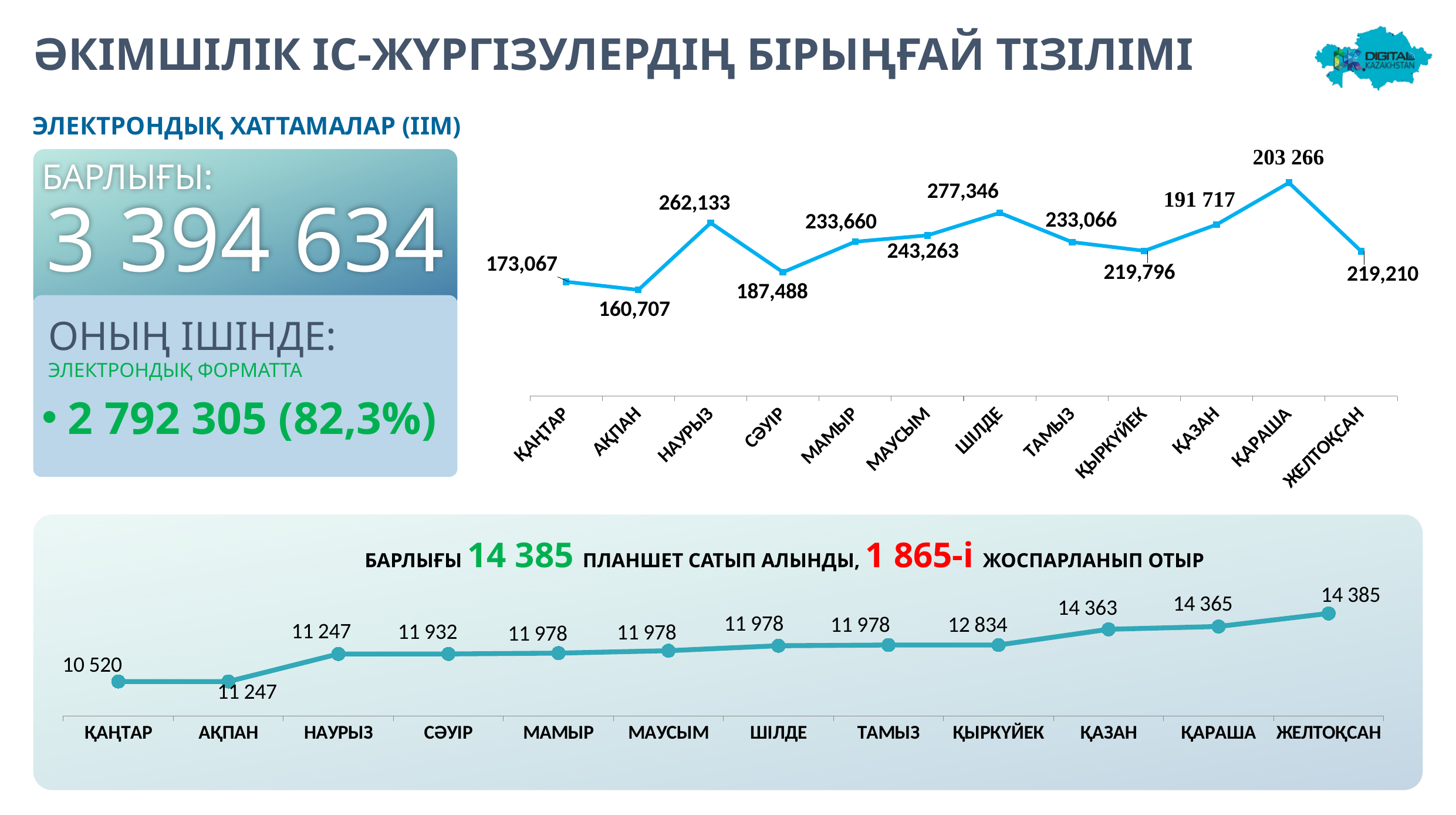
How many months are plotted in the top chart (electronic protocols)? 12 In the bottom chart (tablets), what is the difference between the values for ЖЕЛТОҚСАН and ҚАҢТАР? 3 865 In the top chart (electronic protocols), which is larger: the value for МАМЫР or the value for ҚЫРКҮЙЕК? МАМЫР In the top chart (electronic protocols), what is the value for ҚАҢТАР? 173,067 In the bottom chart (tablets), which month has the lowest value? ҚАҢТАР What kind of chart is the top chart (electronic protocols)? line chart In the top chart (electronic protocols), which month has the lowest value? АҚПАН In the bottom chart (tablets), what is the value for ҚЫРКҮЙЕК? 12 834 In the top chart (electronic protocols), what is the value for ШІЛДЕ? 277,346 In the bottom chart (tablets), do the values generally rise or fall from ҚАҢТАР to ЖЕЛТОҚСАН? rise In the top chart (electronic protocols), what is the difference between the values for НАУРЫЗ and СӘУІР? 74,645